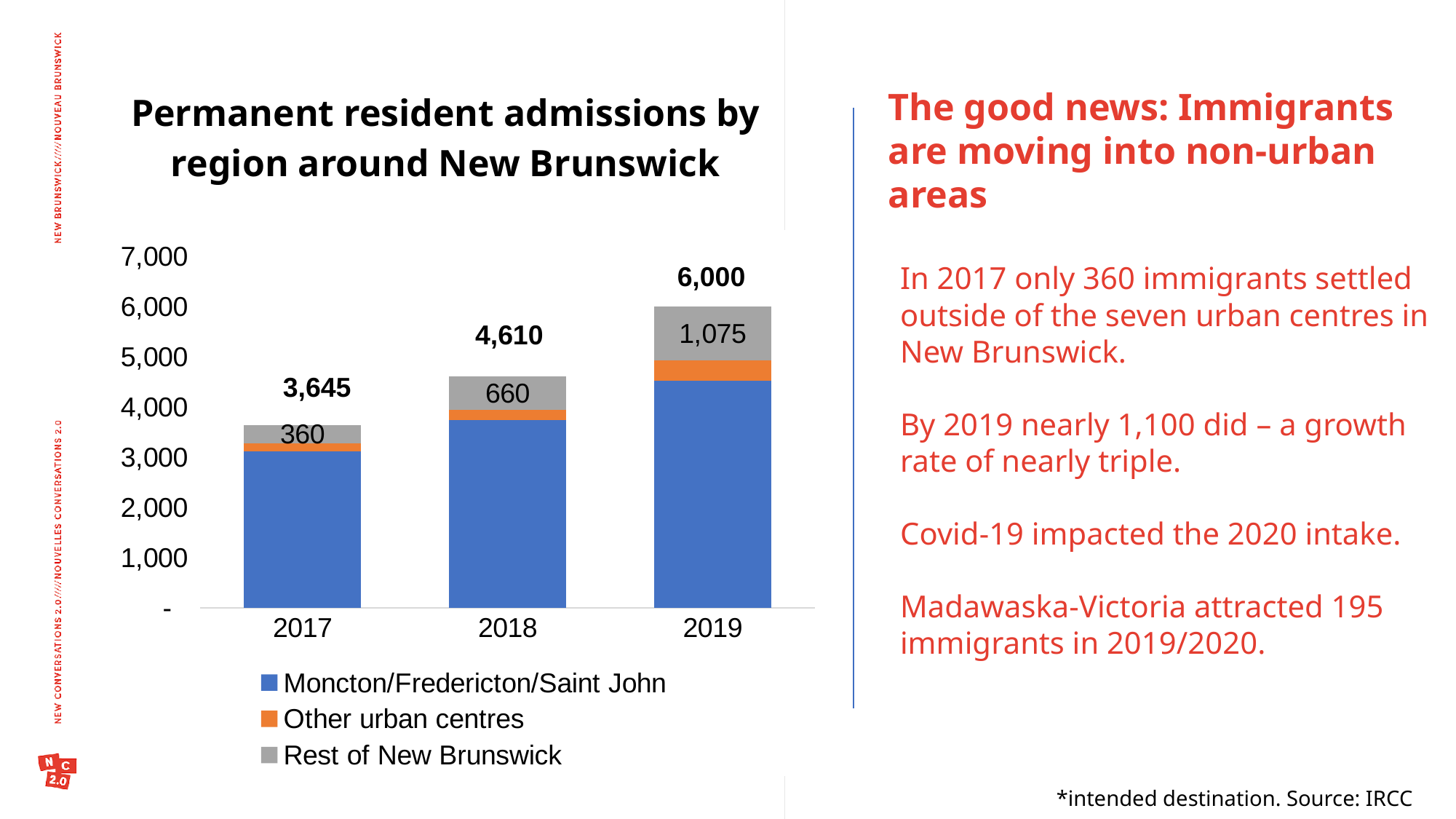
How many admissions are labelled for Rest of New Brunswick in 2019? 1,075 Which year has the lowest total admissions? 2017 What is the total permanent resident admissions shown for 2017? 3,645 What is the total permanent resident admissions shown for 2019? 6,000 By how much did the Rest of New Brunswick admissions increase from 2017 to 2019? 715 How many admissions are labelled for Rest of New Brunswick in 2018? 660 How many series does the legend list? 3 Is the value for Moncton/Fredericton/Saint John in 2019 greater or less than 4,000? greater Which year has the highest total admissions? 2019 What kind of chart is shown on the slide? Stacked bar chart Do the total admissions rise or fall from 2017 to 2019? Rise What is the difference between the total admissions in 2019 and 2017? 2,355